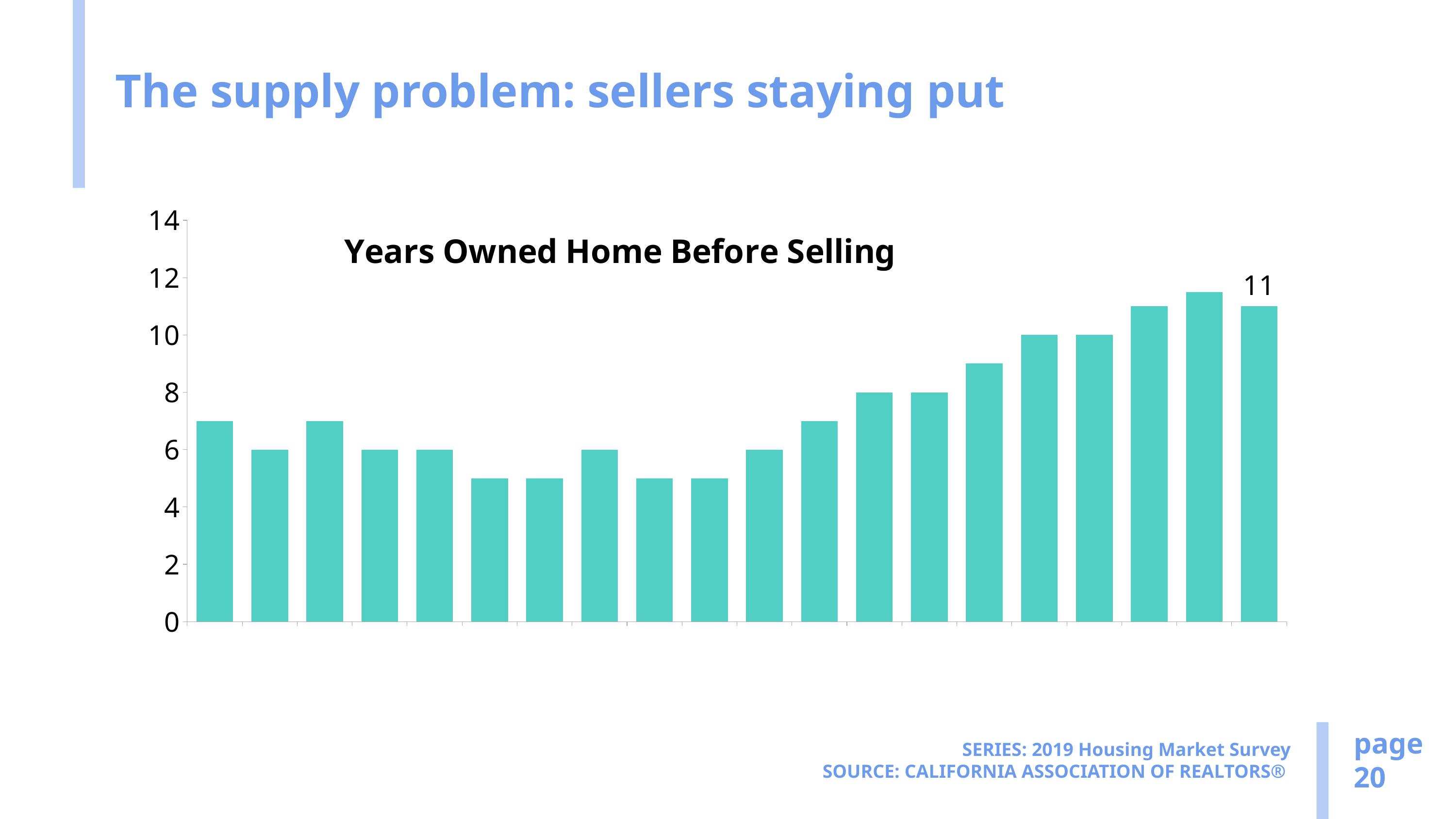
Which bar is the tallest in the chart? the second bar from the right Which is larger, the leftmost bar or the rightmost bar? the rightmost bar What is the title of the chart? Years Owned Home Before Selling What colour are the bars in the chart? teal Is the value of the tallest bar greater or less than 12? less Is the value of the rightmost bar greater or less than 10? greater Is the value of the leftmost bar greater or less than 6? greater What kind of chart is shown on the slide? bar chart How many bars are plotted in the chart? 20 Do the bars in the right half of the chart generally rise or fall from left to right? rise What value is printed as a data label on the rightmost bar? 11